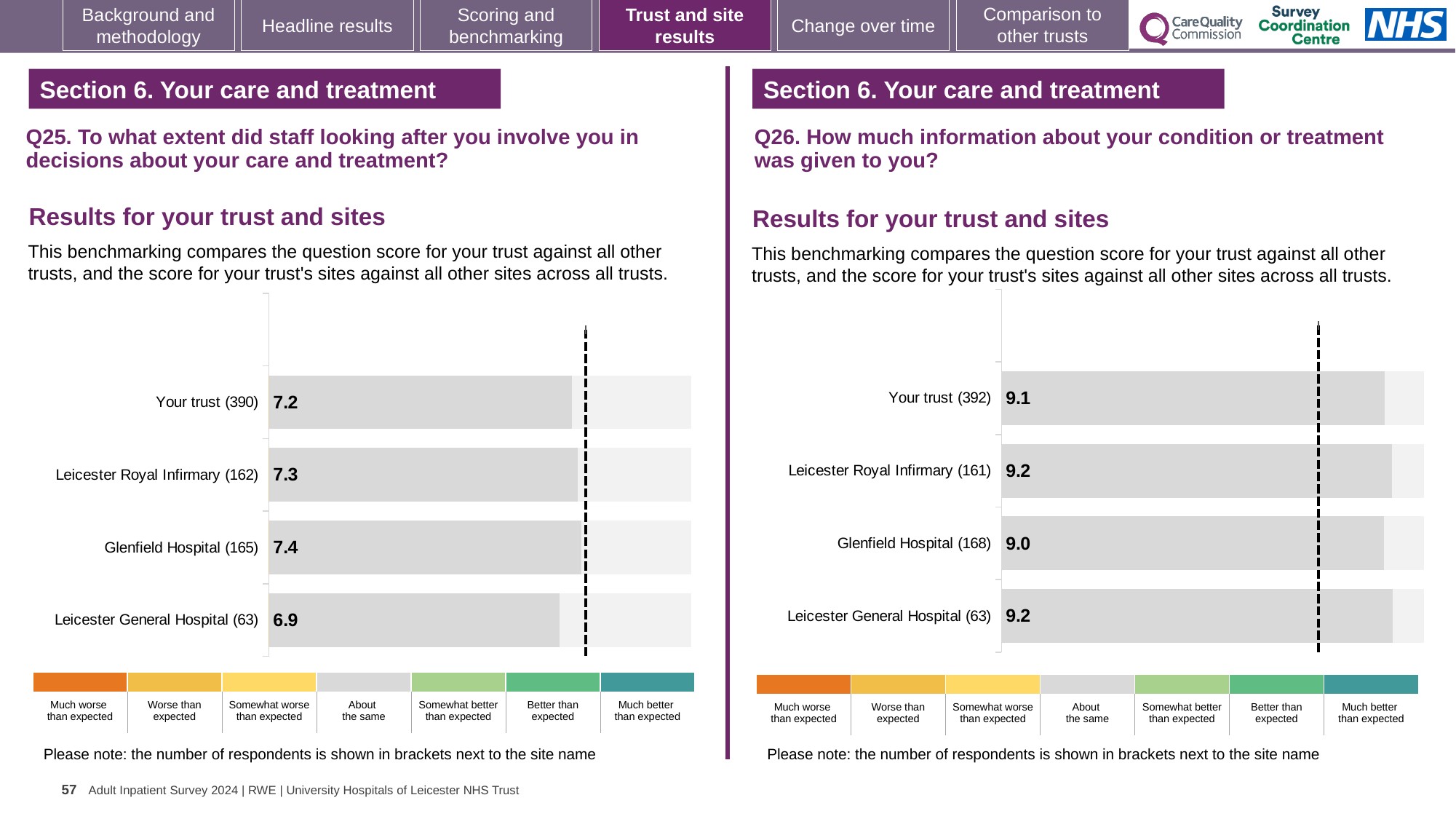
In the Q26 chart on the right, what is the score for Glenfield Hospital? 9.0 In the Q25 chart on the left, which site has the highest score? Glenfield Hospital In the Q25 chart on the left, what is the score for Leicester General Hospital? 6.9 In the Q25 chart on the left, what is the difference between the scores for Glenfield Hospital and Leicester General Hospital? 0.5 In the Q26 chart on the right, how many respondents are shown in brackets for Leicester Royal Infirmary? 161 In the Q26 chart on the right, which has the larger score, Leicester Royal Infirmary or Glenfield Hospital? Leicester Royal Infirmary In the Q26 chart on the right, what is the score for Your trust? 9.1 What kind of chart is used for the Q26 results on the right? Bar chart In the Q25 chart on the left, which site has the lowest score? Leicester General Hospital In the Q25 chart on the left, how many bars are plotted? 4 In the Q26 chart on the right, which site has the lowest score? Glenfield Hospital In the Q25 chart on the left, what is the score for Your trust? 7.2